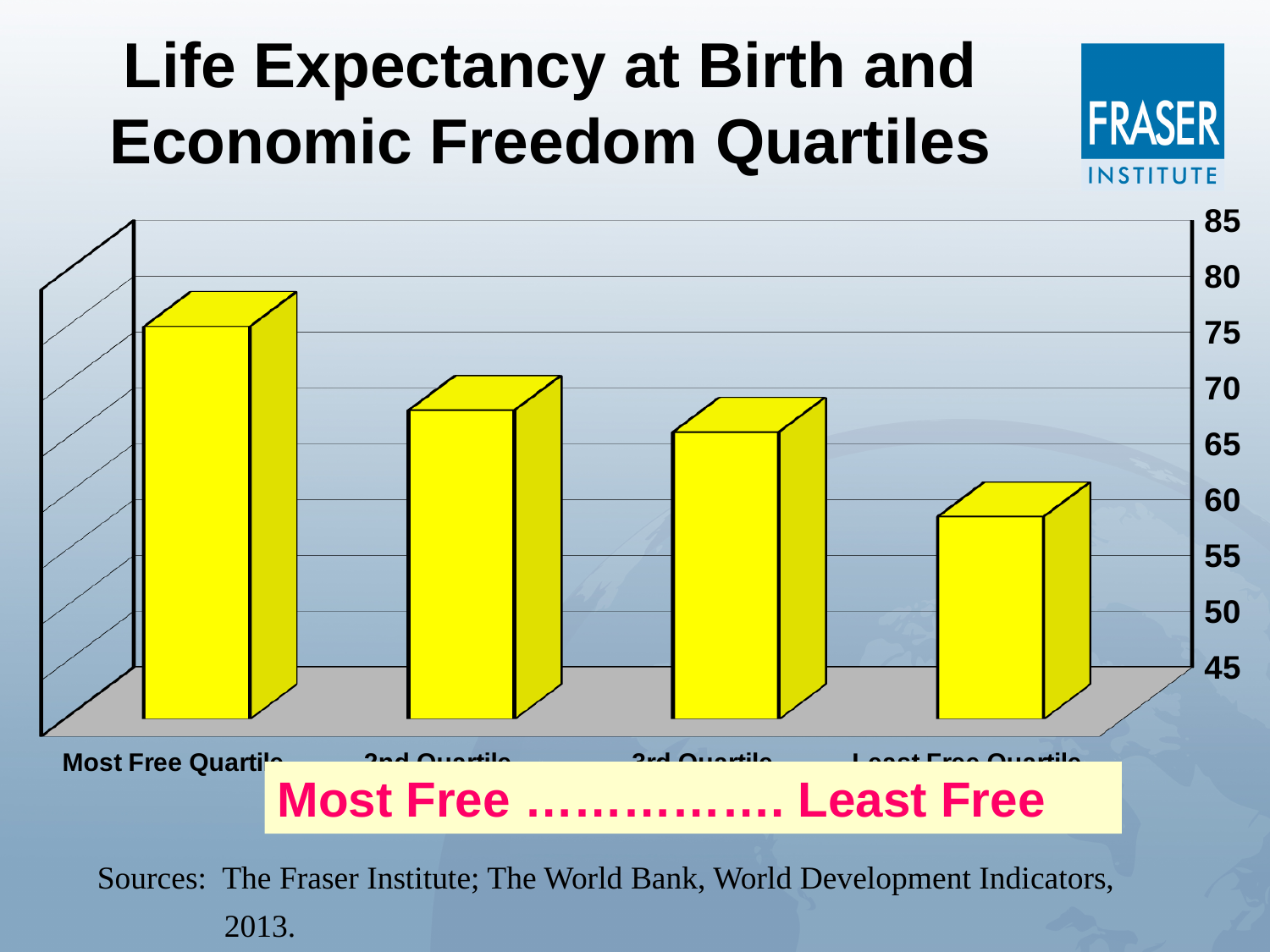
Which has the larger value, the 2nd Quartile or the 3rd Quartile? 2nd Quartile Which has the larger value, the Most Free Quartile or the Least Free Quartile? Most Free Quartile Is the value for the Least Free Quartile greater or less than 65? less Which quartile has the highest life expectancy at birth? Most Free Quartile Which quartile has the lowest life expectancy at birth? Least Free Quartile How many quartile categories are plotted in the chart? 4 What kind of chart is shown on the slide? bar chart Do the bars rise or fall moving from the Most Free Quartile to the Least Free Quartile? fall Is the value for the Most Free Quartile greater or less than 70? greater Is the value for the 2nd Quartile greater or less than 65? greater What is the title of the chart on the slide? Life Expectancy at Birth and Economic Freedom Quartiles